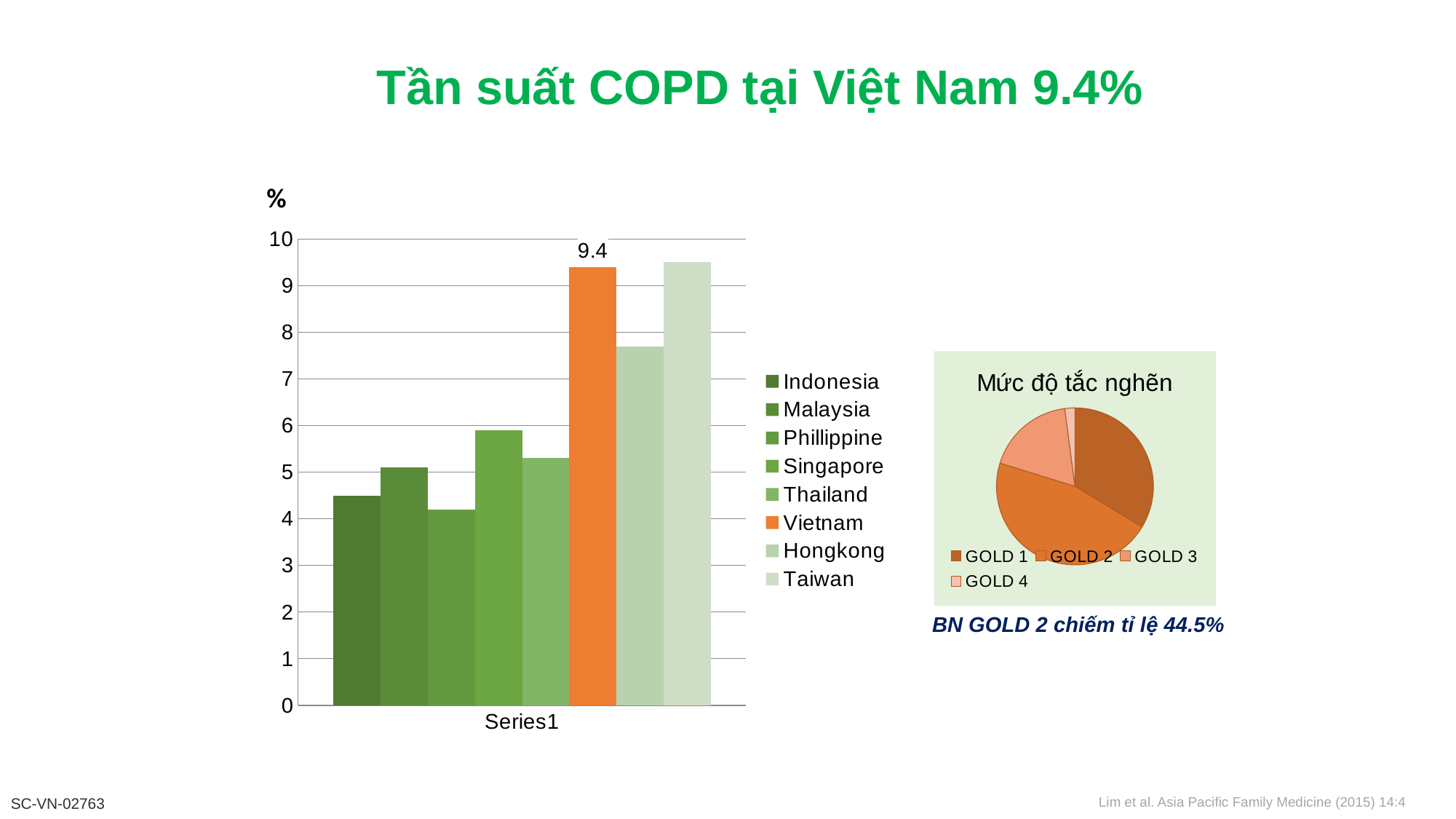
In the bar chart on the left, is the value for Hongkong greater or less than 7? greater In the pie chart 'Mức độ tắc nghẽn', which slice is the smallest? GOLD 4 In the bar chart on the left, what is the value for Vietnam? 9.4 How many entries does the legend of the pie chart 'Mức độ tắc nghẽn' list? 4 In the bar chart on the left, which is larger, the value for Hongkong or the value for Singapore? Hongkong In the bar chart on the left, which is larger, the value for Vietnam or the value for Indonesia? Vietnam In the bar chart on the left, is the value for Indonesia greater or less than 5? less What kind of chart is the chart titled 'Mức độ tắc nghẽn'? pie chart How many series does the legend of the bar chart on the left list? 8 In the pie chart 'Mức độ tắc nghẽn', what share does GOLD 2 have according to the slide? 44.5% What kind of chart is the chart on the left of the slide? bar chart